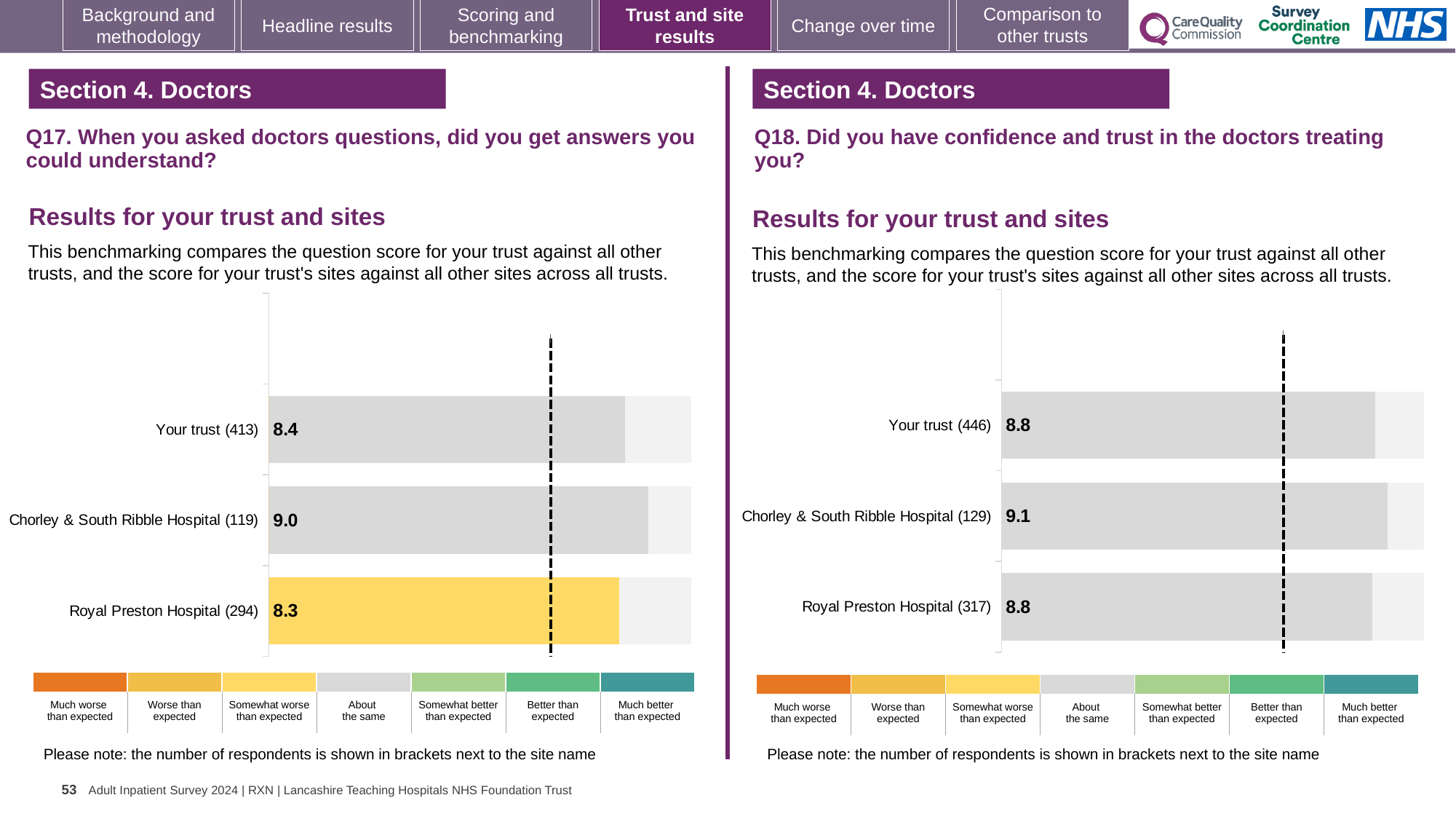
In the Q18 chart on the right, which site or trust has the highest score? Chorley & South Ribble Hospital In the Q17 chart on the left, what is the score for Royal Preston Hospital? 8.3 In the Q17 chart on the left, which site or trust has the lowest score? Royal Preston Hospital In the Q17 chart on the left, which has the larger score, Your trust or Royal Preston Hospital? Your trust In the Q17 chart on the left, which site's bar is coloured yellow rather than grey? Royal Preston Hospital In the Q18 chart on the right, what is the difference between the scores for Chorley & South Ribble Hospital and Your trust? 0.3 In the Q18 chart on the right, what is the score for Chorley & South Ribble Hospital? 9.1 In the Q17 chart on the left, what is the score for Chorley & South Ribble Hospital? 9.0 How many bars are plotted in the Q18 chart on the right? 3 In the Q17 chart on the left, which site or trust has the highest score? Chorley & South Ribble Hospital In the Q17 chart on the left, what is the difference between the scores for Chorley & South Ribble Hospital and Royal Preston Hospital? 0.7 In the Q18 chart on the right, what is the score for Your trust? 8.8